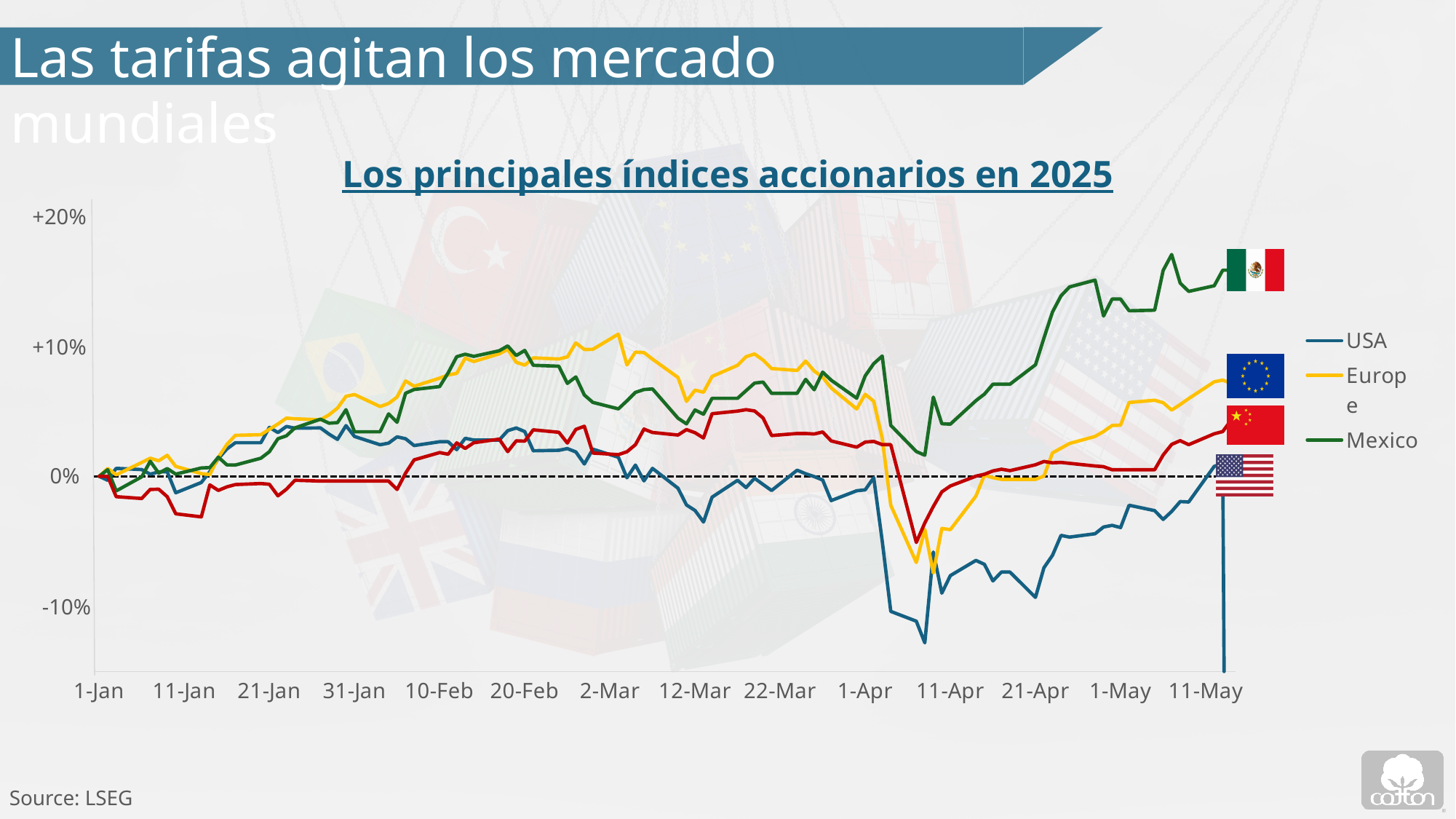
How many series does the chart legend list? 3 Does the Mexico line overall rise or fall from 1-Jan to 11-May? Rise What source is cited for the chart data? LSEG How many date labels are shown on the x axis? 14 Is the value for Europe at the end of the chart greater or less than +10%? less Which series has the lowest value at the right end of the chart (11-May)? USA Is the lowest point of the USA line greater or less than -10%? less Is the value for Mexico at the end of the chart greater or less than +10%? greater Which series has the highest value at the right end of the chart (11-May)? Mexico What is the title of the chart? Los principales índices accionarios en 2025 At the end of the chart, which is larger: the value for Europe or the value for USA? Europe What kind of chart is shown on the slide? Line chart